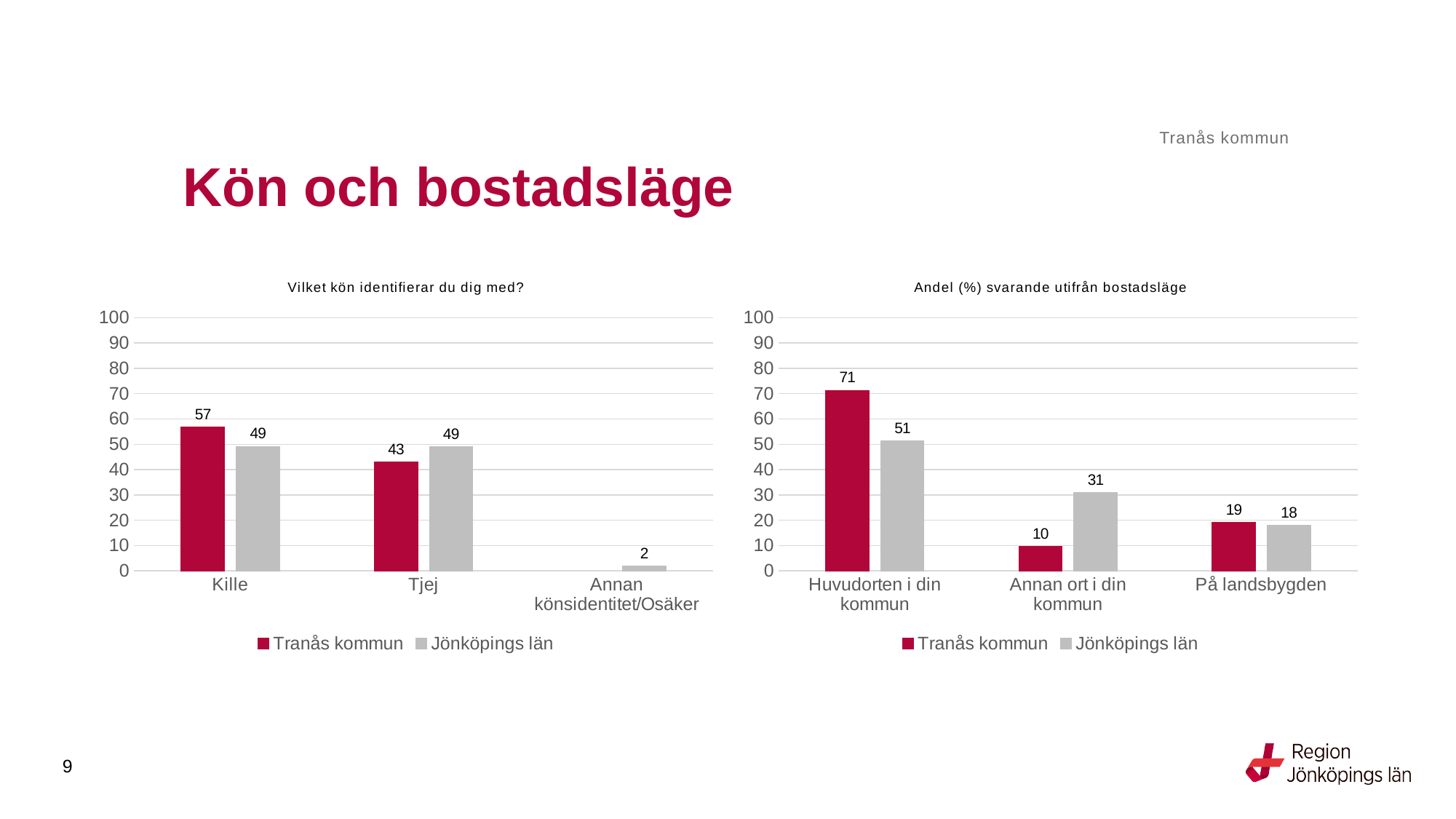
In the chart 'Vilket kön identifierar du dig med?', what is the difference between Tranås kommun and Jönköpings län for Kille? 8 What kind of chart is the chart 'Andel (%) svarande utifrån bostadsläge'? Bar chart In the chart 'Vilket kön identifierar du dig med?', what is the value for Jönköpings län for Annan könsidentitet/Osäker? 2 In the chart 'Andel (%) svarande utifrån bostadsläge', what is the value for Tranås kommun for Huvudorten i din kommun? 71 In the chart 'Andel (%) svarande utifrån bostadsläge', what is the difference between Tranås kommun and Jönköpings län for Huvudorten i din kommun? 20 In the chart 'Vilket kön identifierar du dig med?', which category has the highest value for Tranås kommun? Kille In the chart 'Andel (%) svarande utifrån bostadsläge', what is the value for Jönköpings län for Annan ort i din kommun? 31 In the chart 'Vilket kön identifierar du dig med?', what is the value for Tranås kommun for Kille? 57 In the chart 'Vilket kön identifierar du dig med?', how many series does the legend list? 2 In the chart 'Vilket kön identifierar du dig med?', what is the value for Jönköpings län for Tjej? 49 In the chart 'Andel (%) svarande utifrån bostadsläge', which is larger for Annan ort i din kommun: Tranås kommun or Jönköpings län? Jönköpings län In the chart 'Andel (%) svarande utifrån bostadsläge', which category has the lowest value for Tranås kommun? Annan ort i din kommun